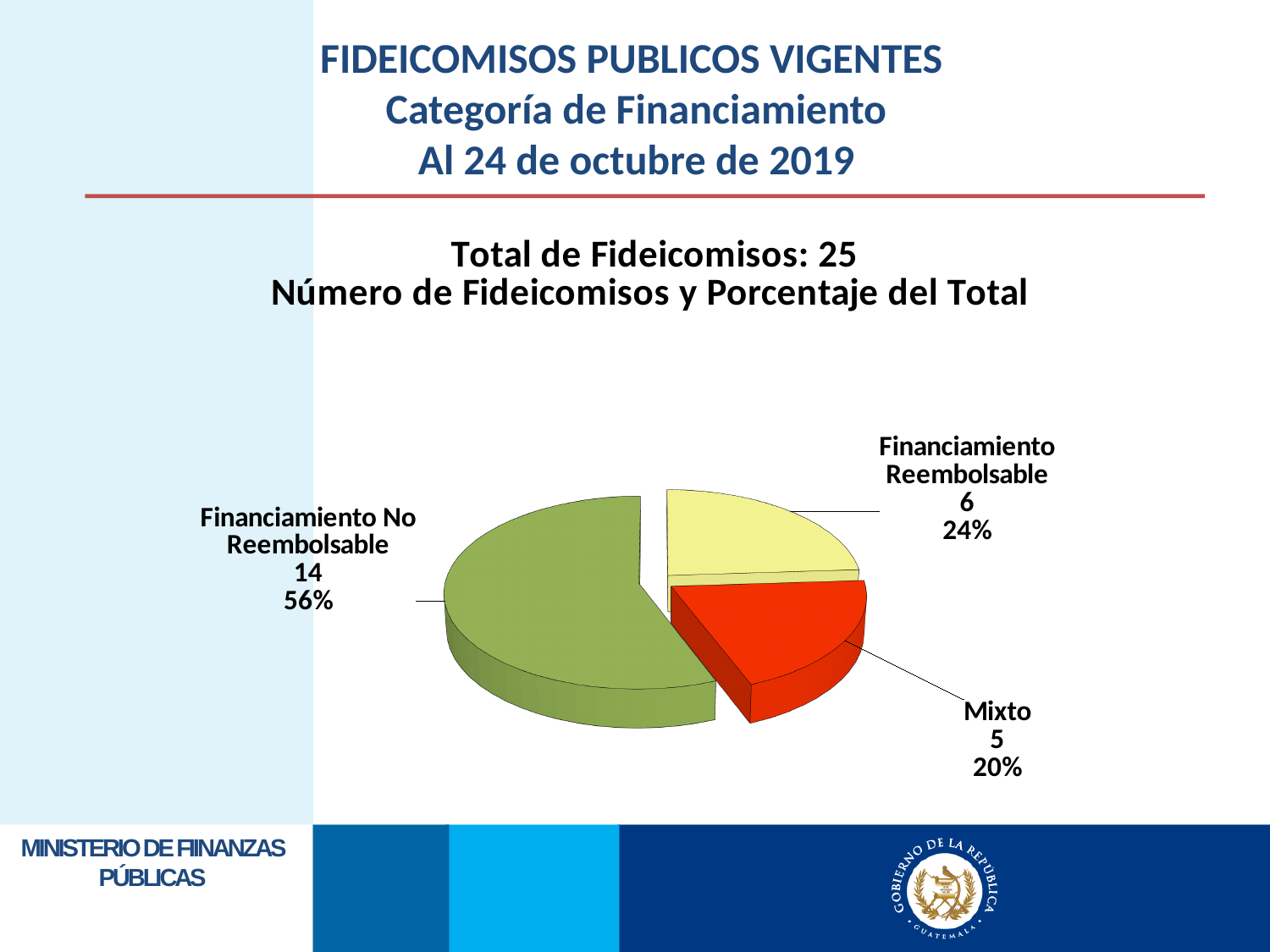
How many fideicomisos are in the Financiamiento No Reembolsable category? 14 What is the difference in the number of fideicomisos between Financiamiento No Reembolsable and Financiamiento Reembolsable? 8 Which has more fideicomisos, Financiamiento Reembolsable or Mixto? Financiamiento Reembolsable What share of the pie does Mixto represent? 20% Which category has the largest number of fideicomisos? Financiamiento No Reembolsable What colour is the Mixto slice of the pie? Red What kind of chart is shown on the slide? Pie chart How many categories are shown in the pie chart? 3 What percentage of the total does Financiamiento Reembolsable represent? 24% How many fideicomisos are in the Mixto category? 5 Which category has the smallest number of fideicomisos? Mixto What is the total number of fideicomisos stated on the slide? 25